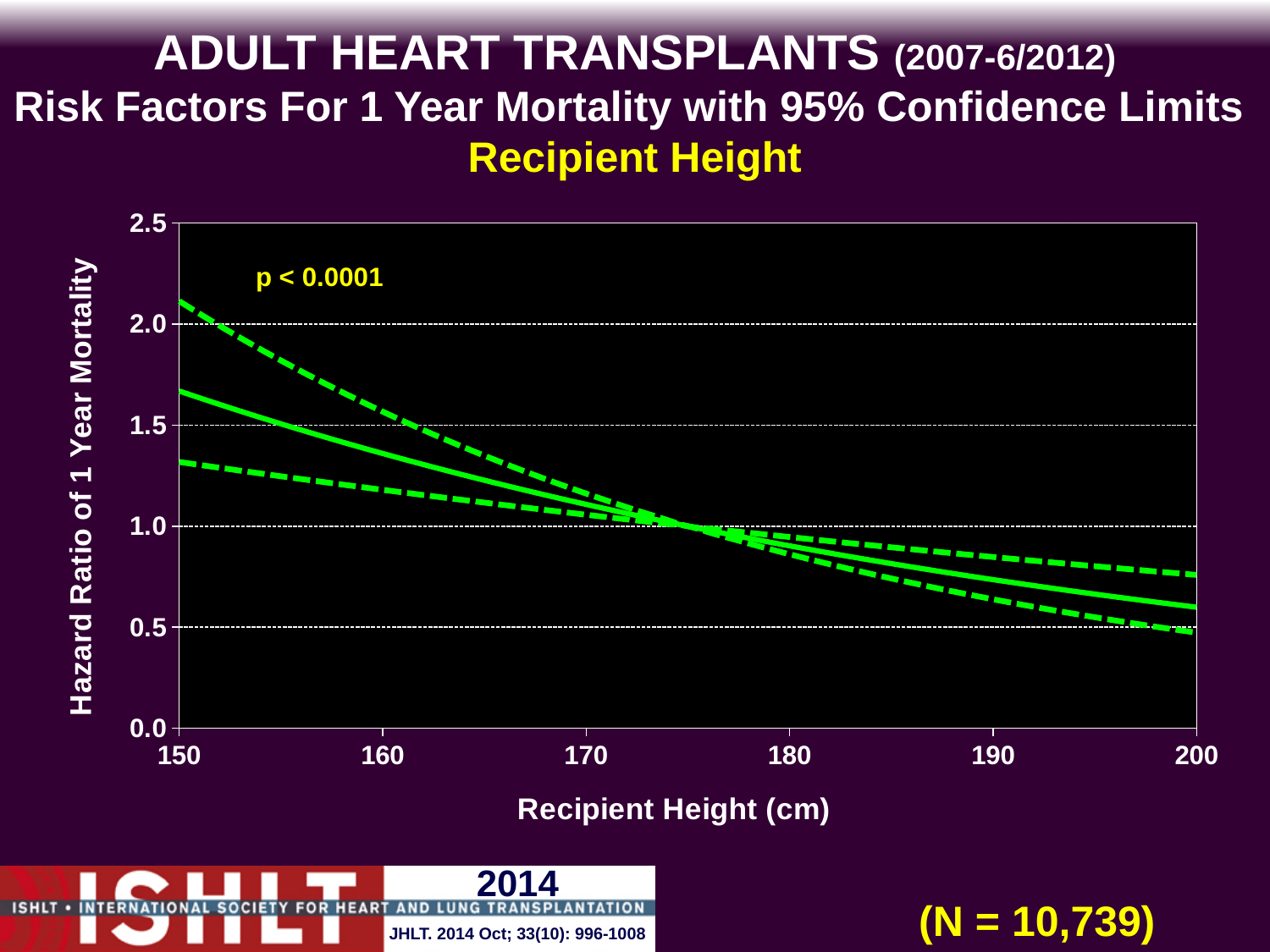
Is the hazard ratio on the solid line higher at a recipient height of 150 cm or at 200 cm? 150 cm What kind of chart is shown on the slide? line chart How many lines are plotted on the chart? 3 What p-value is printed on the chart? p < 0.0001 Is the hazard ratio on the solid line at a recipient height of 160 cm greater or less than 1.0? greater What is the sample size (N) shown on the slide? N = 10,739 Is the hazard ratio on the solid line at a recipient height of 200 cm greater or less than 1.0? less Is the lower confidence limit (lower dashed line) at a recipient height of 150 cm greater or less than 1.5? less Does the hazard ratio of 1 year mortality rise or fall as recipient height increases from 150 cm to 200 cm? fall